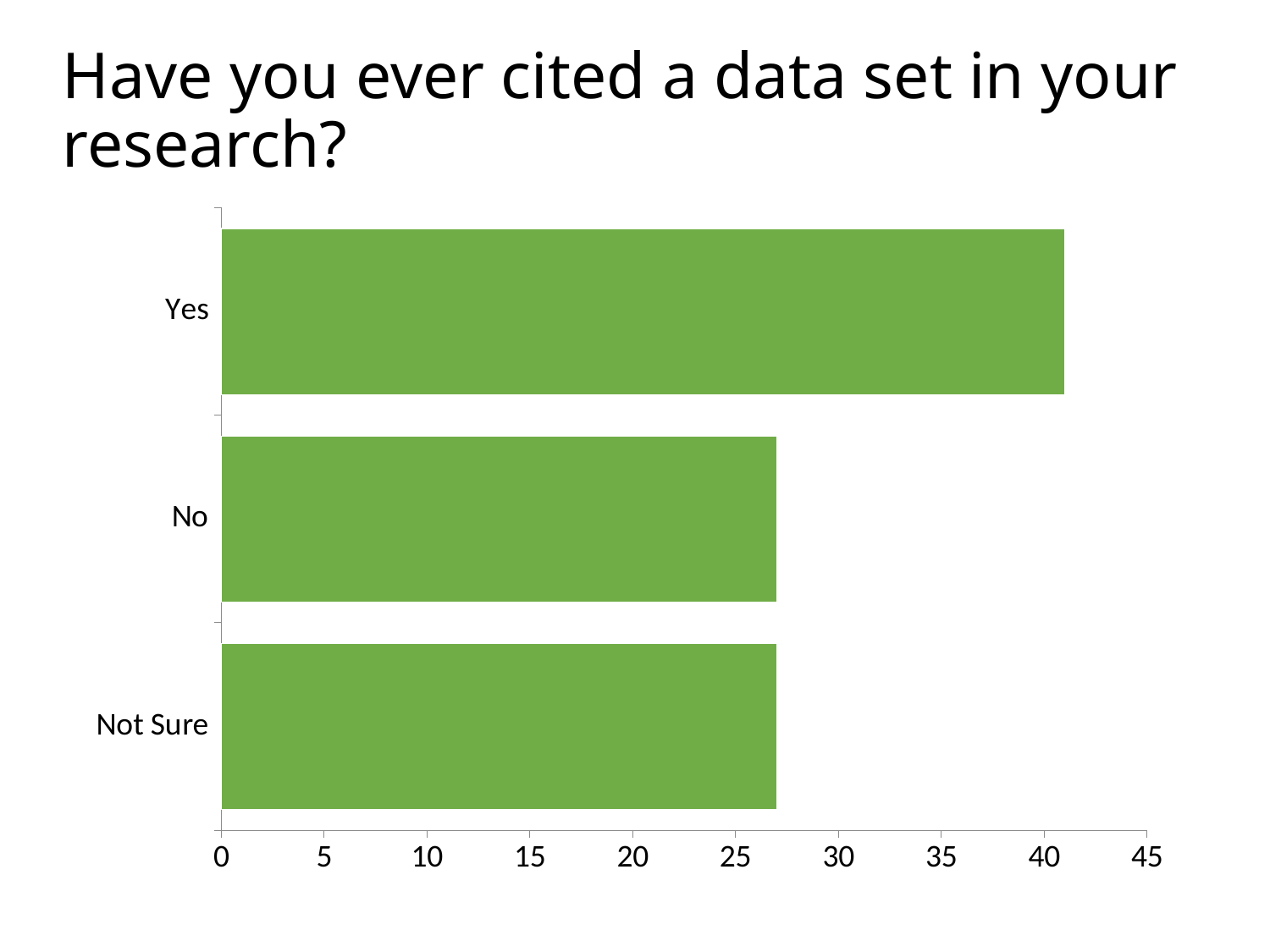
Is the value for Not Sure greater or less than 30? less Is the value for No greater or less than 30? less Which category has the highest value? Yes Is the value for Yes greater or less than 40? greater How many categories are shown in the chart? 3 What kind of chart is shown on the slide? bar chart What colour are the bars in the chart? green Which is larger, the value for Yes or the value for No? Yes What is the title of the slide above the chart? Have you ever cited a data set in your research?